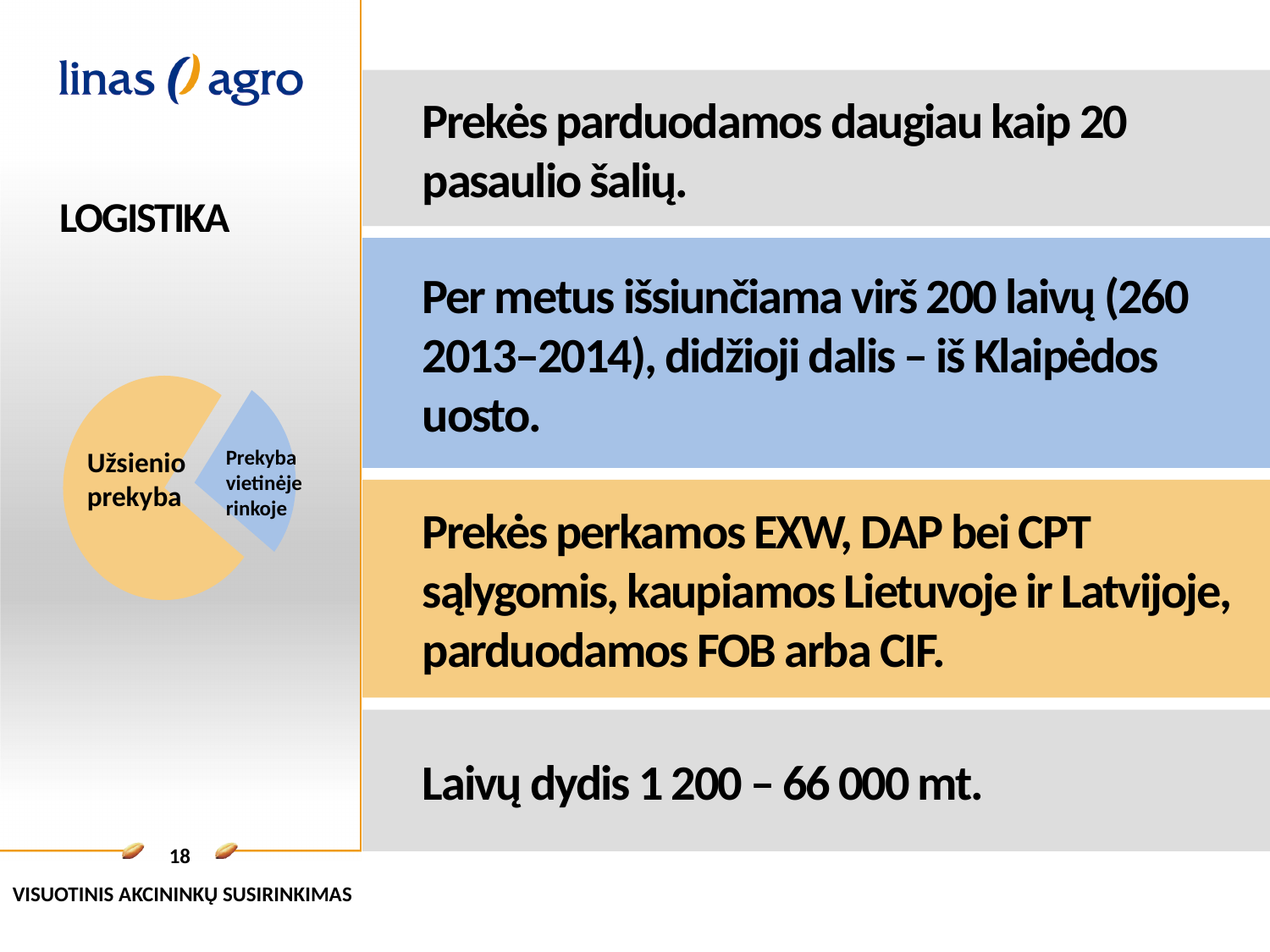
Which slice of the pie chart is pulled out (exploded) from the rest of the pie? Prekyba vietinėje rinkoje What kind of chart is shown on the slide? pie chart Which slice of the pie chart is the largest? Užsienio prekyba Which slice of the pie chart is the smallest? Prekyba vietinėje rinkoje Which slice is larger in the pie chart, Užsienio prekyba or Prekyba vietinėje rinkoje? Užsienio prekyba How many slices does the pie chart have? 2 What colour is the Užsienio prekyba slice in the pie chart? orange